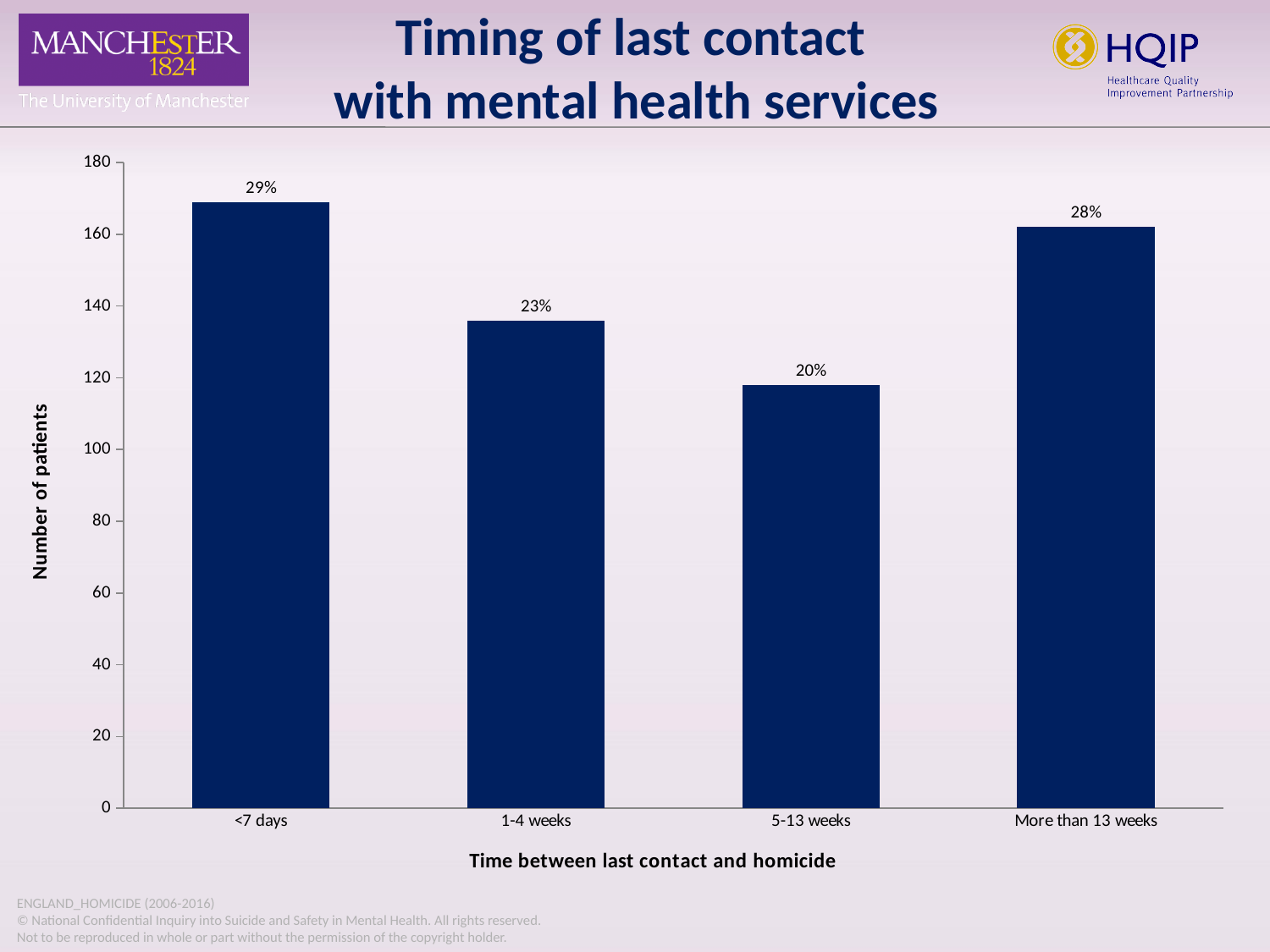
What percentage label is shown on the bar for More than 13 weeks? 28% What percentage label is shown on the bar for 1-4 weeks? 23% Which time category has the highest number of patients? <7 days What is the difference in percentage points between the <7 days bar and the 5-13 weeks bar? 9 percentage points Which has more patients: 1-4 weeks or More than 13 weeks? More than 13 weeks How many time categories are shown on the x axis? 4 Is the number of patients for 5-13 weeks greater or less than 120? less What type of chart is shown on the slide? Bar chart What percentage label is shown on the bar for 5-13 weeks? 20% Is the number of patients for <7 days greater or less than 160? greater Which time category has the lowest number of patients? 5-13 weeks What percentage label is shown on the bar for <7 days? 29%